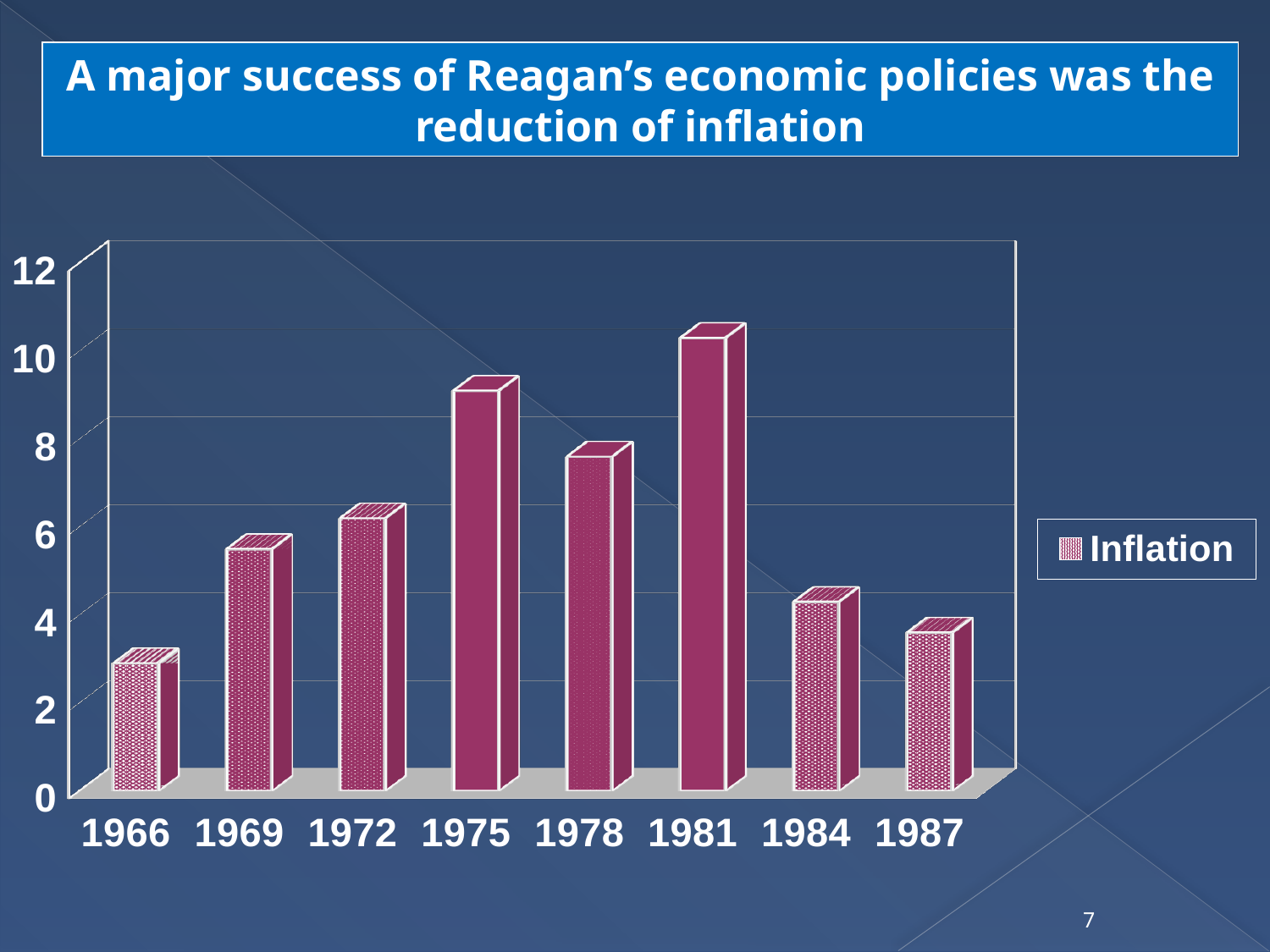
Which year has the lowest inflation bar? 1966 What kind of chart is shown on the slide? bar chart What is the name of the series shown in the legend? Inflation How many years are shown on the x axis of the chart? 8 Which year has the highest inflation bar? 1981 Is the inflation value for 1966 greater or less than 4? less How many series does the chart's legend list? 1 Is the inflation value for 1975 greater or less than 8? greater Which year has the higher inflation value, 1969 or 1972? 1972 Which year has the higher inflation value, 1975 or 1978? 1975 From 1981 to 1987, do the inflation values rise or fall? fall Is the inflation value for 1981 greater or less than 8? greater